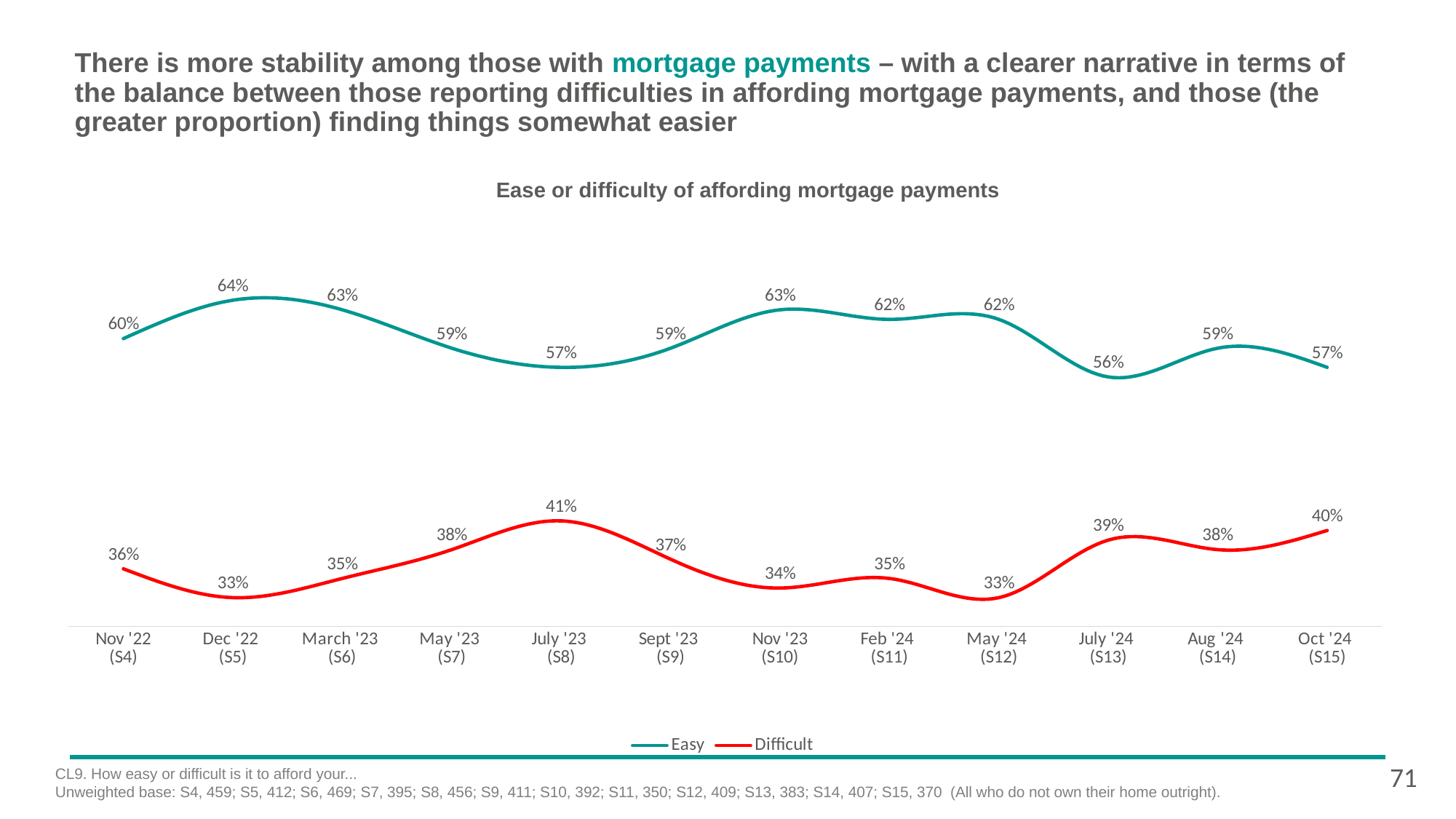
What is the title of the chart? Ease or difficulty of affording mortgage payments What is the value for Easy in Oct '24 (S15)? 57% What is the value for Easy in Dec '22 (S5)? 64% At which time point is the Easy series at its lowest? July '24 (S13) At which time point is the Easy series at its highest? Dec '22 (S5) How many series does the legend list? 2 What is the difference between the Easy and Difficult values in Oct '24 (S15)? 17 percentage points What type of chart is shown on the slide? Line chart What is the value for Difficult in July '23 (S8)? 41% How many time points are plotted along the x axis? 12 At which time point is the Difficult series at its highest? July '23 (S8) Which is larger in May '24 (S12): the Easy value or the Difficult value? Easy